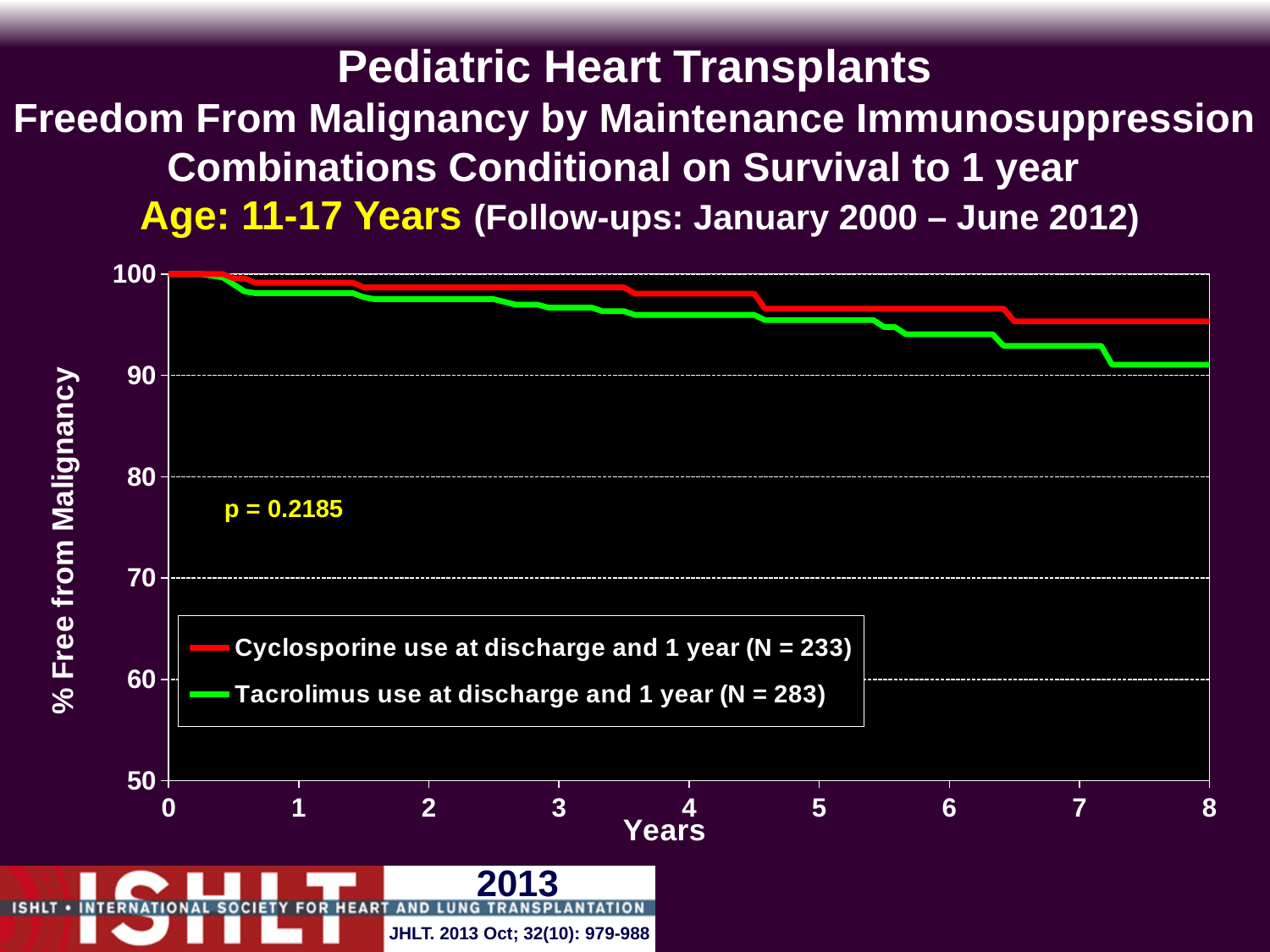
What is the N for the Cyclosporine use at discharge and 1 year group? N = 233 What p-value is printed on the chart? p = 0.2185 What is the lowest value shown on the y axis? 50 Which series is drawn in green? Tacrolimus use at discharge and 1 year What is the N for the Tacrolimus use at discharge and 1 year group? N = 283 What kind of chart is shown on the slide? Line chart What is the label of the x axis? Years How many series does the legend list? 2 Do the curves rise or fall as years increase along the x axis? Fall Is the value for the Cyclosporine group at 8 years greater or less than 90? greater At 8 years, which group has the higher % free from malignancy, Cyclosporine or Tacrolimus? Cyclosporine Is the value for the Tacrolimus group at 6 years greater or less than 90? greater